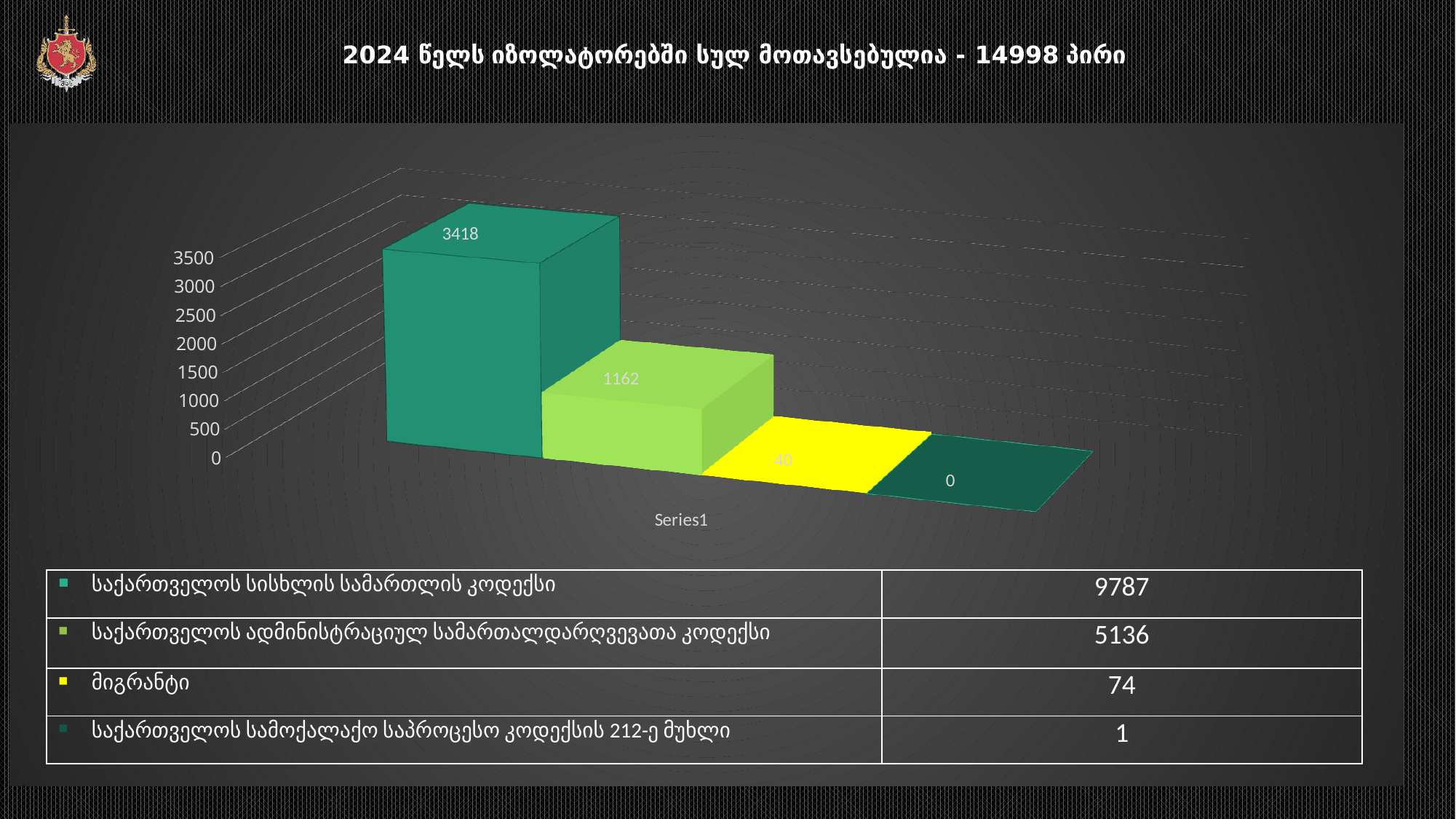
What value is labelled on the tallest (teal) bar in the chart? 3418 What value is labelled on the dark green bar (საქართველოს სამოქალაქო საპროცესო კოდექსის 212-ე მუხლი) in the chart? 0 How many bars are plotted in the chart? 4 Is the value of the teal bar greater or less than 3000? greater What label is shown on the horizontal axis of the chart? Series1 Which bar has the highest value in the chart? the teal bar (საქართველოს სისხლის სამართლის კოდექსი), 3418 What value is labelled on the yellow bar (მიგრანტი) in the chart? 40 What value is labelled on the light green bar in the chart? 1162 What is the difference between the teal bar (3418) and the light green bar (1162)? 2256 What kind of chart is shown on the slide? bar chart Which is larger, the light green bar or the yellow bar? the light green bar Which bar has the lowest value in the chart? the dark green bar (საქართველოს სამოქალაქო საპროცესო კოდექსის 212-ე მუხლი), 0